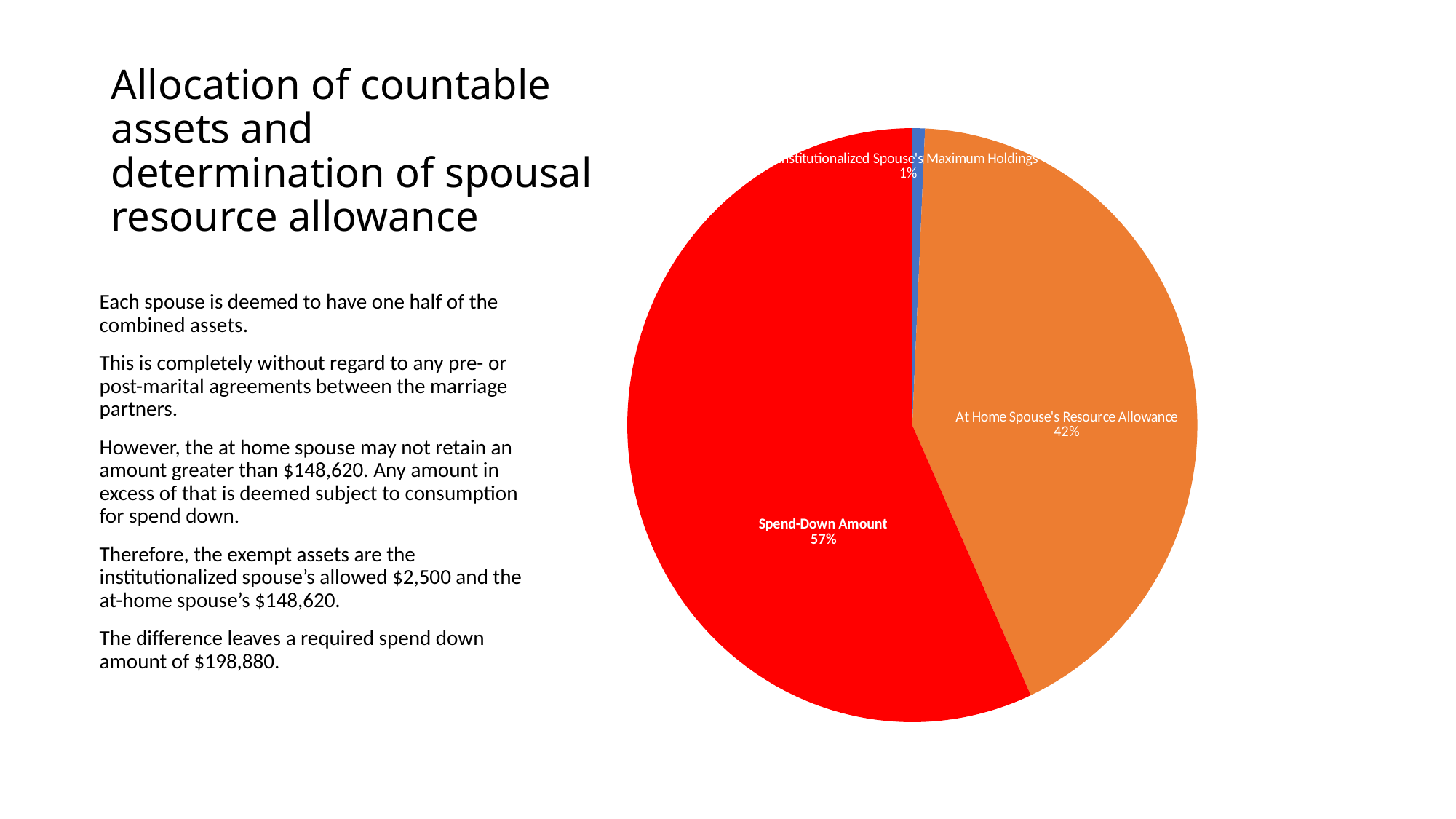
Which slice of the pie is the smallest? Institutionalized Spouse's Maximum Holdings What kind of chart is shown on the slide? pie chart What share of the pie does Institutionalized Spouse's Maximum Holdings represent? 1% What is the difference in percentage points between the At Home Spouse's Resource Allowance slice and the Institutionalized Spouse's Maximum Holdings slice? 41% Which is larger, the Spend-Down Amount slice or the At Home Spouse's Resource Allowance slice? Spend-Down Amount What colour is the Spend-Down Amount slice? red How many slices does the pie chart have? 3 What colour is the At Home Spouse's Resource Allowance slice? orange Which slice of the pie is the largest? Spend-Down Amount What is the difference in percentage points between the Spend-Down Amount slice and the At Home Spouse's Resource Allowance slice? 15% What share of the pie does At Home Spouse's Resource Allowance represent? 42% What share of the pie does Spend-Down Amount represent? 57%